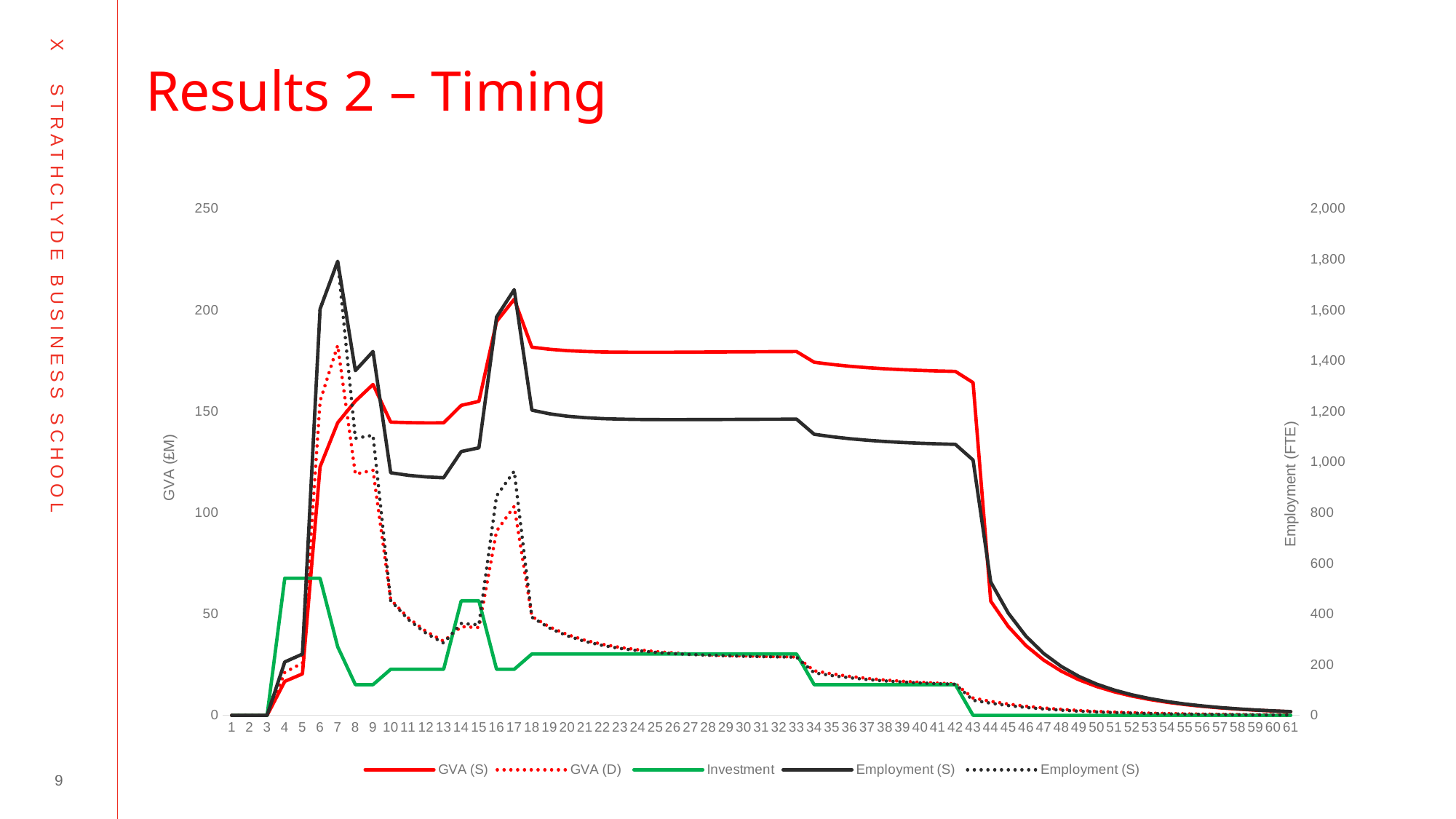
Is the value of GVA (S) at point 50 greater or less than 50 on the left axis? less How many points are on the x axis of the chart? 61 At point 30, which is larger: GVA (S) or GVA (D)? GVA (S) Is the value of Investment at point 4 greater or less than 50 on the left axis? greater What kind of chart is shown on the slide? Line chart Does GVA (S) rise or fall from point 43 to point 61? Fall What is the title of the left vertical axis? GVA (£M) Is the value of the solid Employment (S) line at point 20 greater or less than 1,000 on the right axis? greater Is the Investment value larger at point 5 or at point 10? Point 5 How many series does the legend list? 5 What colour is the Investment line? Green